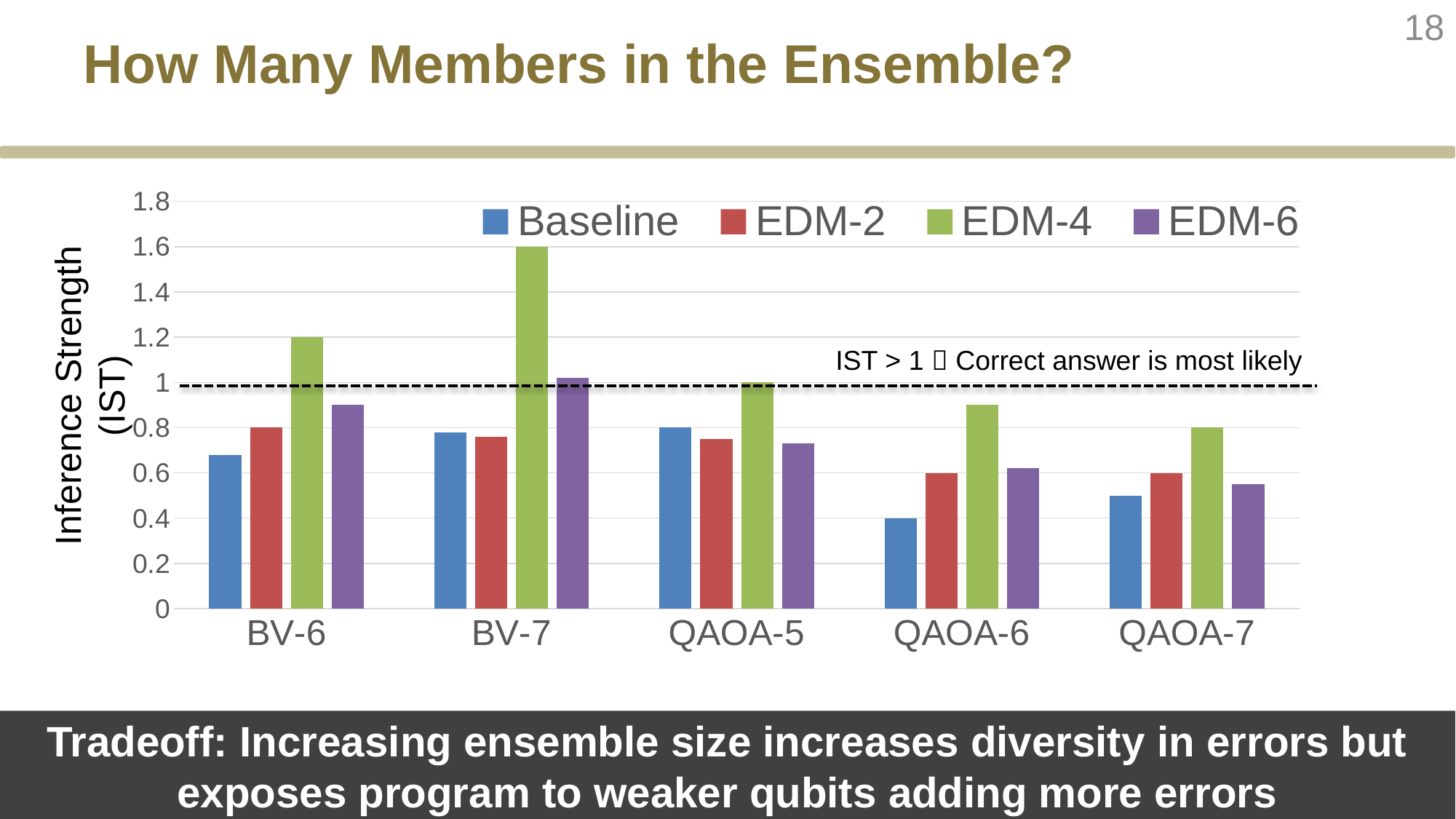
Is the EDM-4 value for BV-7 greater or less than 1.4? greater What kind of chart is shown on the slide? bar chart For BV-6, which is larger: the Baseline bar or the EDM-4 bar? EDM-4 How many series does the legend list? 4 Which benchmark has the highest EDM-4 bar? BV-7 Is the EDM-6 value for QAOA-7 greater or less than 0.6? less Is the EDM-6 value for BV-6 greater or less than 1? less What is the label of the y axis? Inference Strength (IST) How many benchmark categories are shown on the x axis? 5 Which benchmark has the lowest Baseline bar? QAOA-6 What is the Baseline value for QAOA-6? 0.4 What is the EDM-4 value for BV-7? 1.6